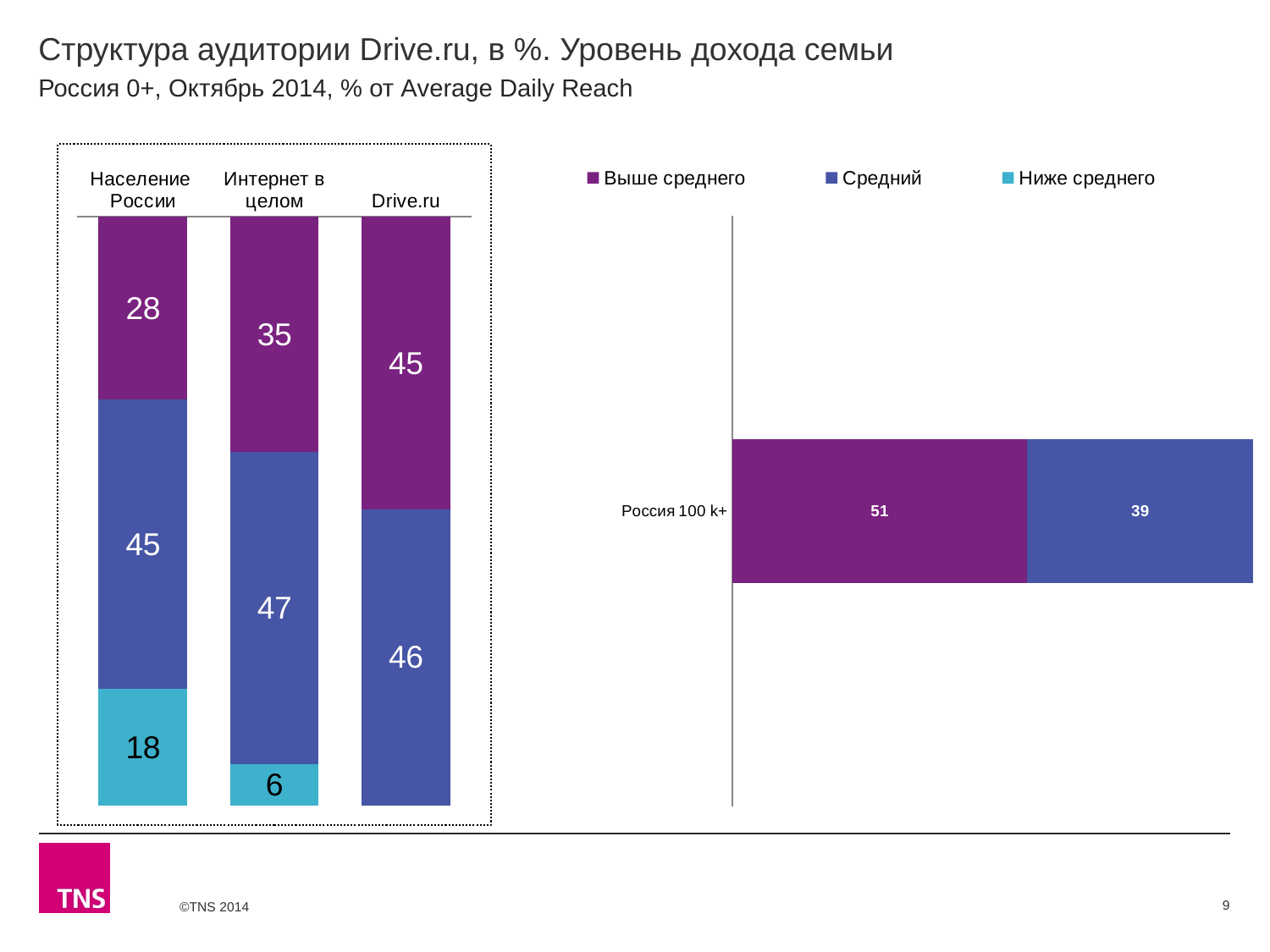
In the left chart, which category has the lowest value for Выше среднего? Население России In the right chart, which is larger for Россия 100 k+: Выше среднего or Средний? Выше среднего In the left chart, which category has the highest value for Выше среднего? Drive.ru In the right chart, what is the value of Выше среднего for Россия 100 k+? 51 In the left chart, what is the value of Выше среднего for Drive.ru? 45 What kind of chart is the right chart? bar chart In the left chart, what is the value of Средний for Население России? 45 In the right chart, what is the difference between the Выше среднего and Средний values for Россия 100 k+? 12 How many categories are shown in the left chart? 3 How many series does the legend list? 3 In the left chart, what is the difference between the Выше среднего values for Drive.ru and Население России? 17 In the left chart, what is the value of Ниже среднего for Интернет в целом? 6